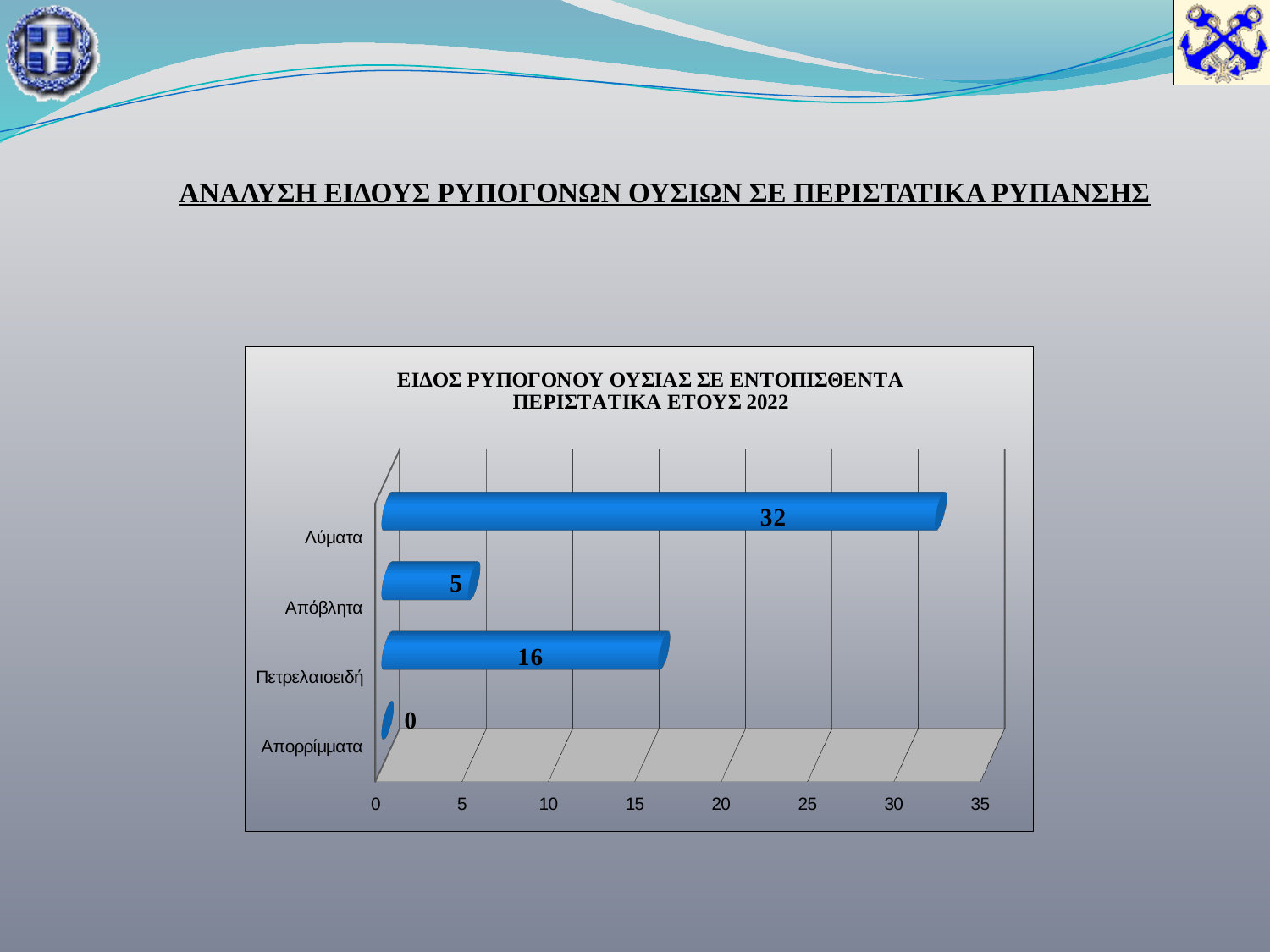
Which category has the lowest value? Απορρίμματα How many categories are shown in the chart? 4 What is the value for Απόβλητα? 5 What is the value for Λύματα? 32 What is the value for Πετρελαιοειδή? 16 What is the title of the chart? ΕΙΔΟΣ ΡΥΠΟΓΟΝΟΥ ΟΥΣΙΑΣ ΣΕ ΕΝΤΟΠΙΣΘΕΝΤΑ ΠΕΡΙΣΤΑΤΙΚΑ ΕΤΟΥΣ 2022 What is the value for Απορρίμματα? 0 What is the difference between the values for Λύματα and Πετρελαιοειδή? 16 Which category has the highest value? Λύματα What is the difference between the values for Πετρελαιοειδή and Απόβλητα? 11 Which is larger, the value for Απόβλητα or the value for Πετρελαιοειδή? Πετρελαιοειδή What kind of chart is shown on the slide? Bar chart